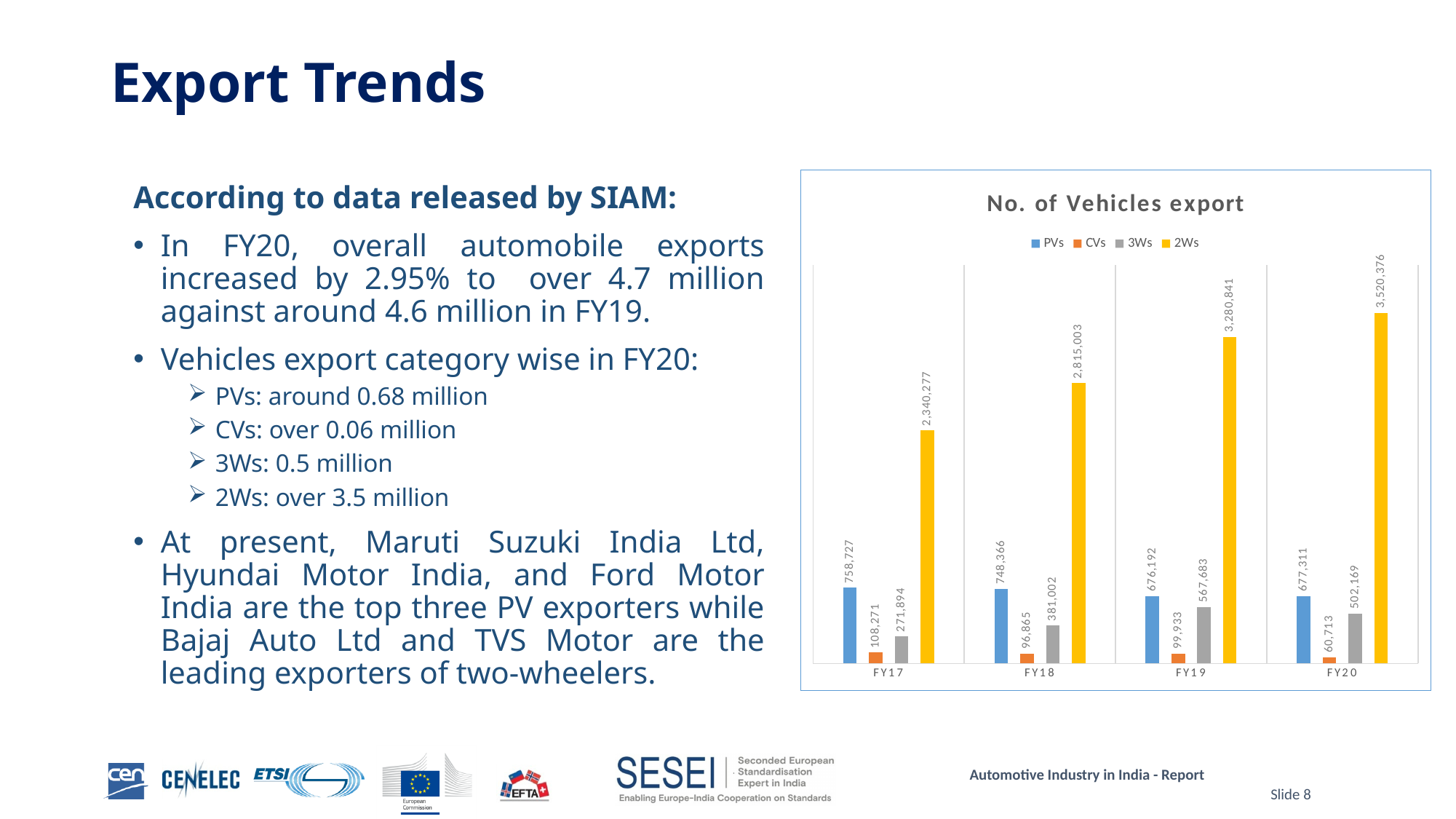
What is the value for 2Ws in FY20? 3,520,376 In which fiscal year is the 2Ws export value highest? FY20 How many series does the legend list? 4 What is the difference between the 3Ws values for FY19 and FY18? 186,681 In which fiscal year is the CVs export value lowest? FY20 What is the value for PVs in FY17? 758,727 What is the value for CVs in FY19? 99,933 How many fiscal years are shown on the x axis? 4 What is the difference between the 2Ws values for FY20 and FY19? 239,535 Which is larger, the PVs value in FY17 or the PVs value in FY20? FY17 What is the value for 3Ws in FY18? 381,002 Do the 2Ws values rise or fall from FY17 to FY20? rise